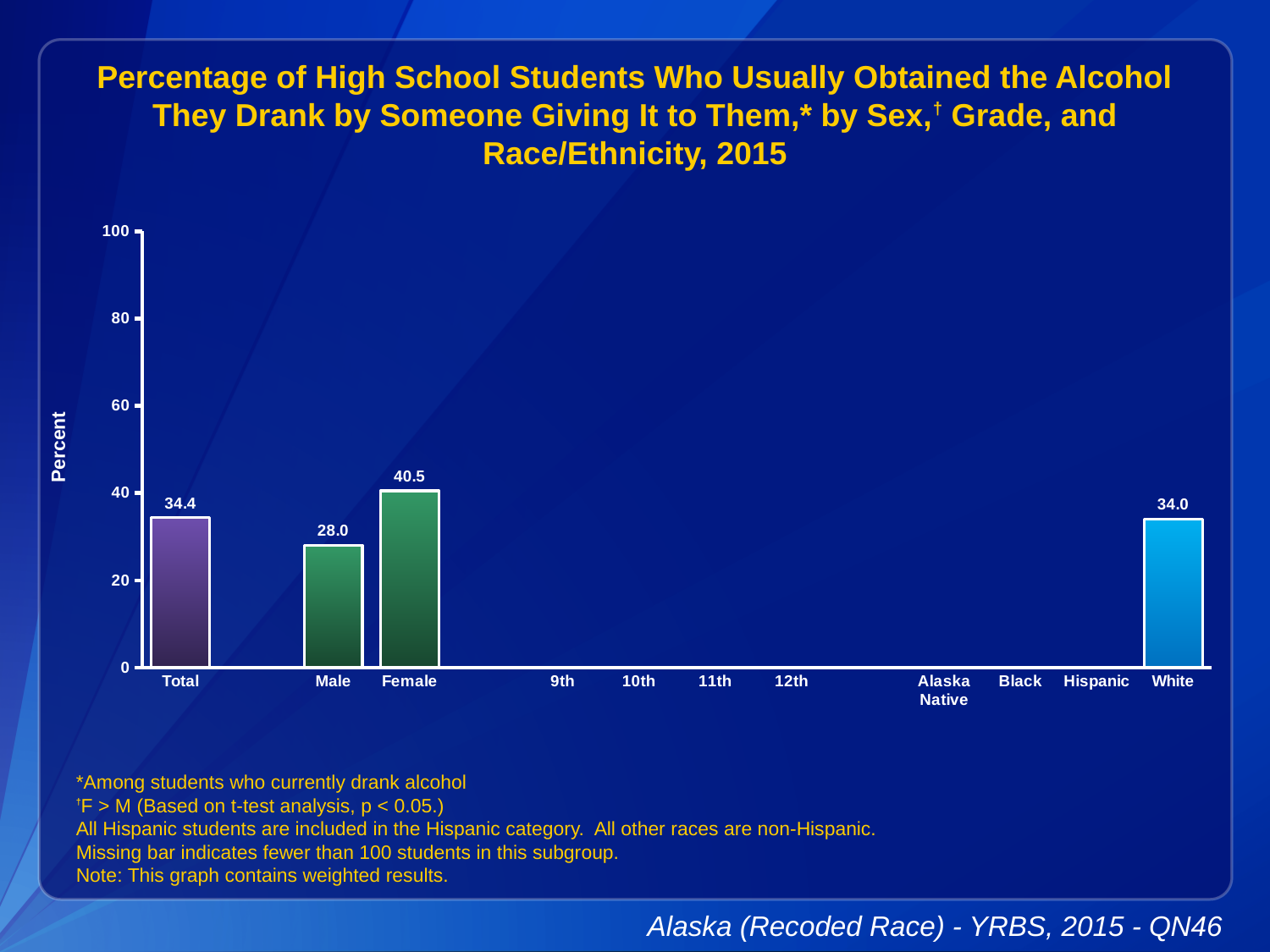
What is the label on the y axis? Percent What is the value for Female? 40.5 What is the value for Total? 34.4 How many bars are plotted on the chart? 4 Is the value for Female greater or less than 40? greater What is the difference between the Female and Male values? 12.5 What is the value for White? 34.0 What is the value for Male? 28.0 Which category has the highest bar? Female Which is larger, the value for Male or the value for Female? Female Which category with a bar shown has the lowest value? Male What kind of chart is shown? bar chart